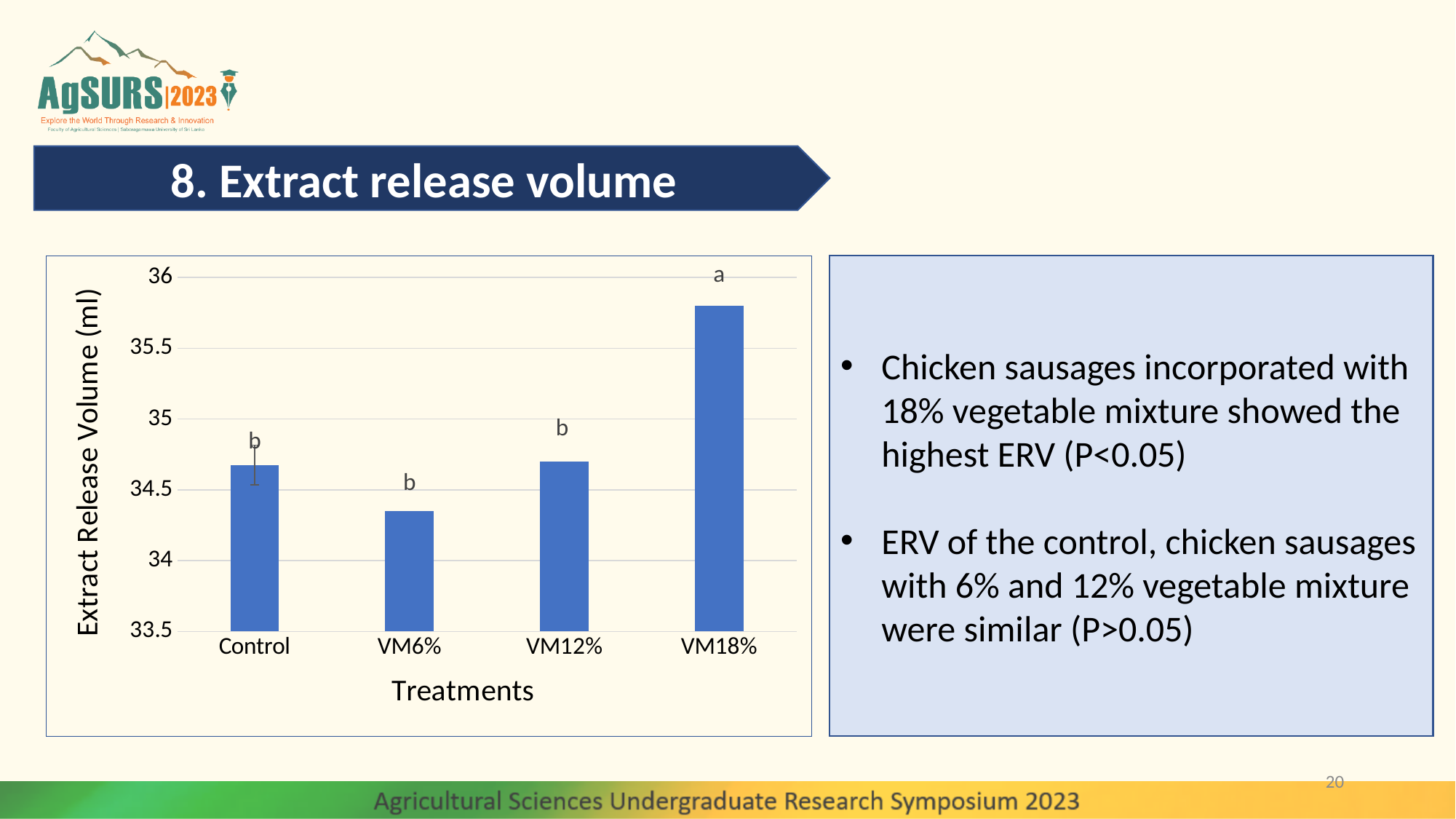
Is the extract release volume for VM6% greater or less than 34.5? less What is the label of the y axis of the chart? Extract Release Volume (ml) Is the extract release volume for VM12% greater or less than 35? less Which has a larger extract release volume, VM6% or VM12%? VM12% What kind of chart is shown on the slide? bar chart Is the extract release volume for Control greater or less than 34.5? greater How many treatments are plotted on the x axis of the chart? 4 Which treatment has the highest extract release volume? VM18% Which has a larger extract release volume, Control or VM18%? VM18% What letter is printed above the VM18% bar? a Which treatment has the lowest extract release volume? VM6%